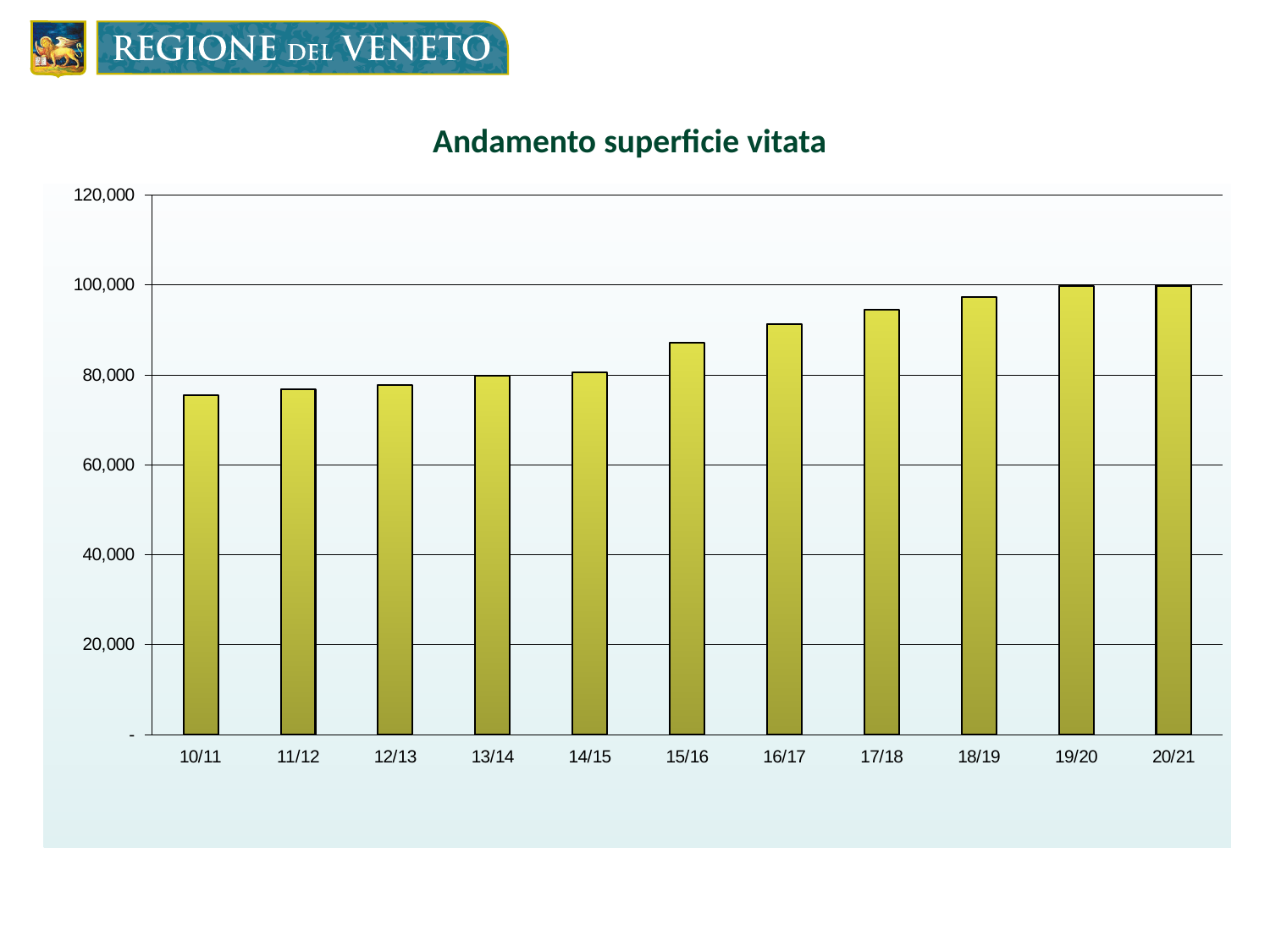
Is the value for 16/17 greater or less than 100,000? less Do the values generally rise or fall from 10/11 to 20/21? rise Is the value for 10/11 greater or less than 80,000? less What kind of chart is shown on the slide? bar chart Is the value for 18/19 greater or less than 100,000? less How many categories (seasons) are shown on the x axis? 11 What is the title of the chart? Andamento superficie vitata Which is larger, the value for 16/17 or the value for 18/19? 18/19 Which is larger, the value for 15/16 or the value for 12/13? 15/16 What is the label of the first category on the x axis? 10/11